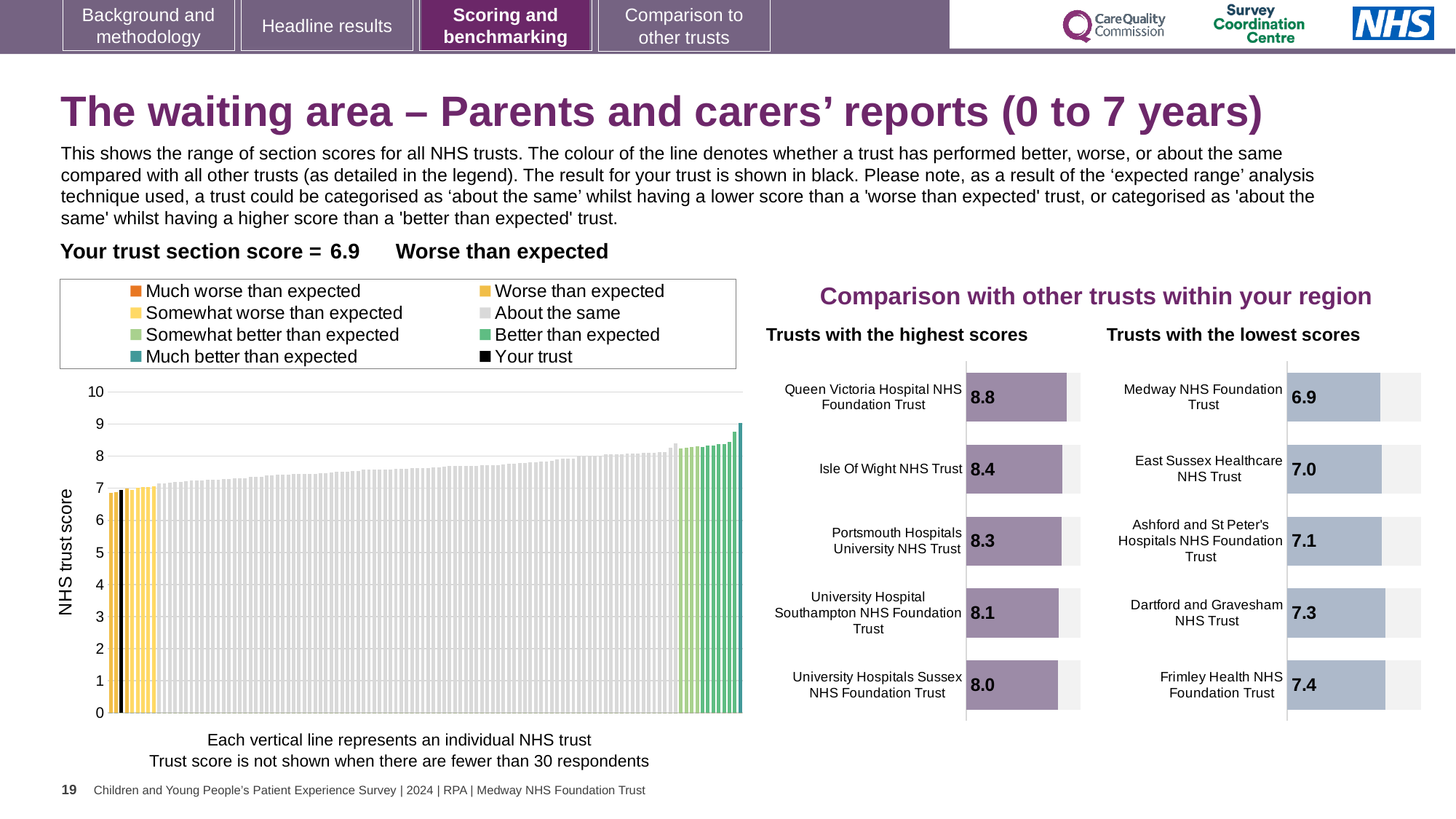
In the 'Trusts with the lowest scores' chart, which trust has the highest score? Frimley Health NHS Foundation Trust In the large chart on the left, do the trust scores rise or fall from left to right? Rise How many entries does the legend of the large chart on the left list? 8 In the 'Trusts with the highest scores' chart, what is the score for Queen Victoria Hospital NHS Foundation Trust? 8.8 Which has a higher score: Portsmouth Hospitals University NHS Trust in the highest-scores chart or Ashford and St Peter's Hospitals NHS Foundation Trust in the lowest-scores chart? Portsmouth Hospitals University NHS Trust In the 'Trusts with the highest scores' chart, which trust has the lowest score? University Hospitals Sussex NHS Foundation Trust In the 'Trusts with the highest scores' chart, what is the difference between the scores of Queen Victoria Hospital NHS Foundation Trust and Isle Of Wight NHS Trust? 0.4 What is the y-axis label of the large chart on the left? NHS trust score In the 'Trusts with the lowest scores' chart, what is the score for Dartford and Gravesham NHS Trust? 7.3 How many trusts are shown in the 'Trusts with the lowest scores' chart? 5 What type of chart is the large chart on the left showing NHS trust scores? Bar chart In the 'Trusts with the lowest scores' chart, what is the difference between the scores of Frimley Health NHS Foundation Trust and Medway NHS Foundation Trust? 0.5